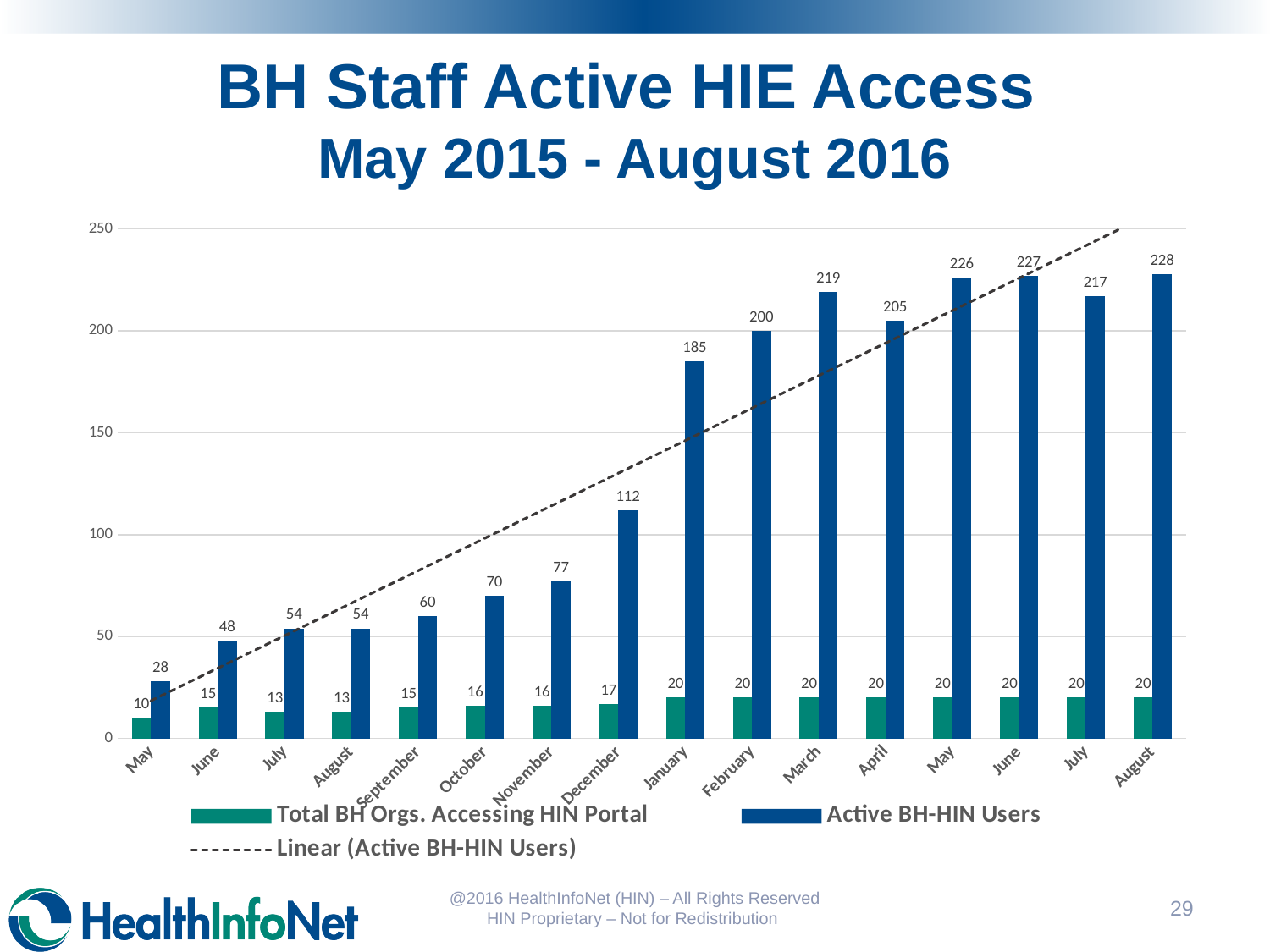
What is the difference between Active BH-HIN Users in January and in December? 73 Which month has the highest value for Active BH-HIN Users? August (the last category, August 2016), with 228 Do the Active BH-HIN Users values generally rise or fall from May 2015 to August 2016? Rise What is the value of Active BH-HIN Users in December? 112 How many months are shown on the x axis? 16 Which is larger, Active BH-HIN Users in March or in April? March Which month has the lowest value for Active BH-HIN Users? May (the first category, May 2015), with 28 What is the value of Total BH Orgs. Accessing HIN Portal in October? 16 What kind of chart is shown on the slide? Bar chart with a linear trendline Is the value for Active BH-HIN Users in November greater or less than 100? less How many entries does the legend list? 3 What is the value of Active BH-HIN Users in February? 200